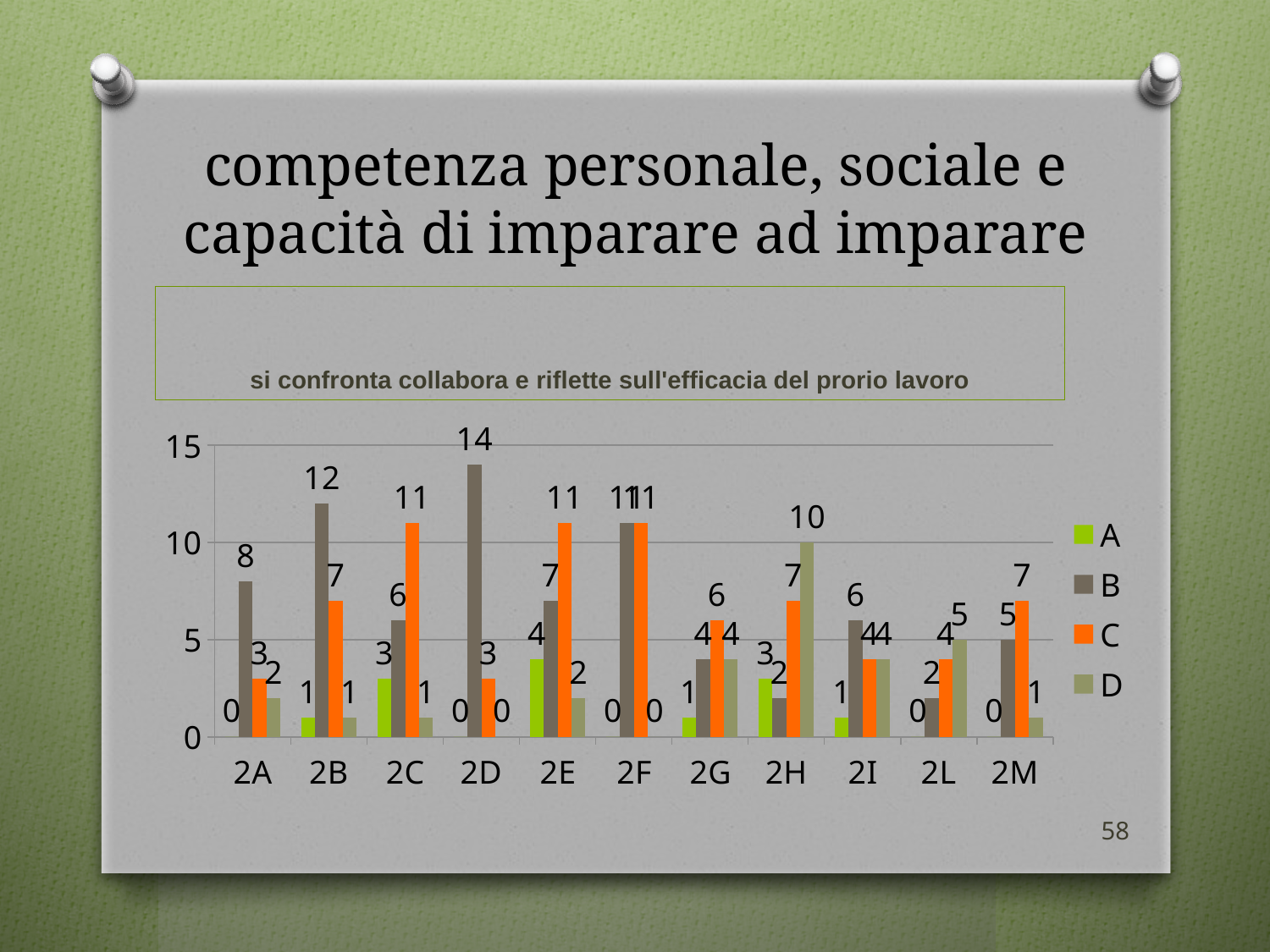
How many categories are shown on the x axis? 11 How many series does the legend list? 4 What is the value of series B for category 2D? 14 Which category has the highest value for series B? 2D What is the value of series D for category 2H? 10 For category 2H, which is larger: series C or series D? D What is the value of series A for category 2E? 4 What is the difference between series B and series C for category 2B? 5 What is the value of series C for category 2C? 11 What is the title of the chart? si confronta collabora e riflette sull'efficacia del prorio lavoro Which category has the highest value for series D? 2H What kind of chart is shown on the slide? bar chart